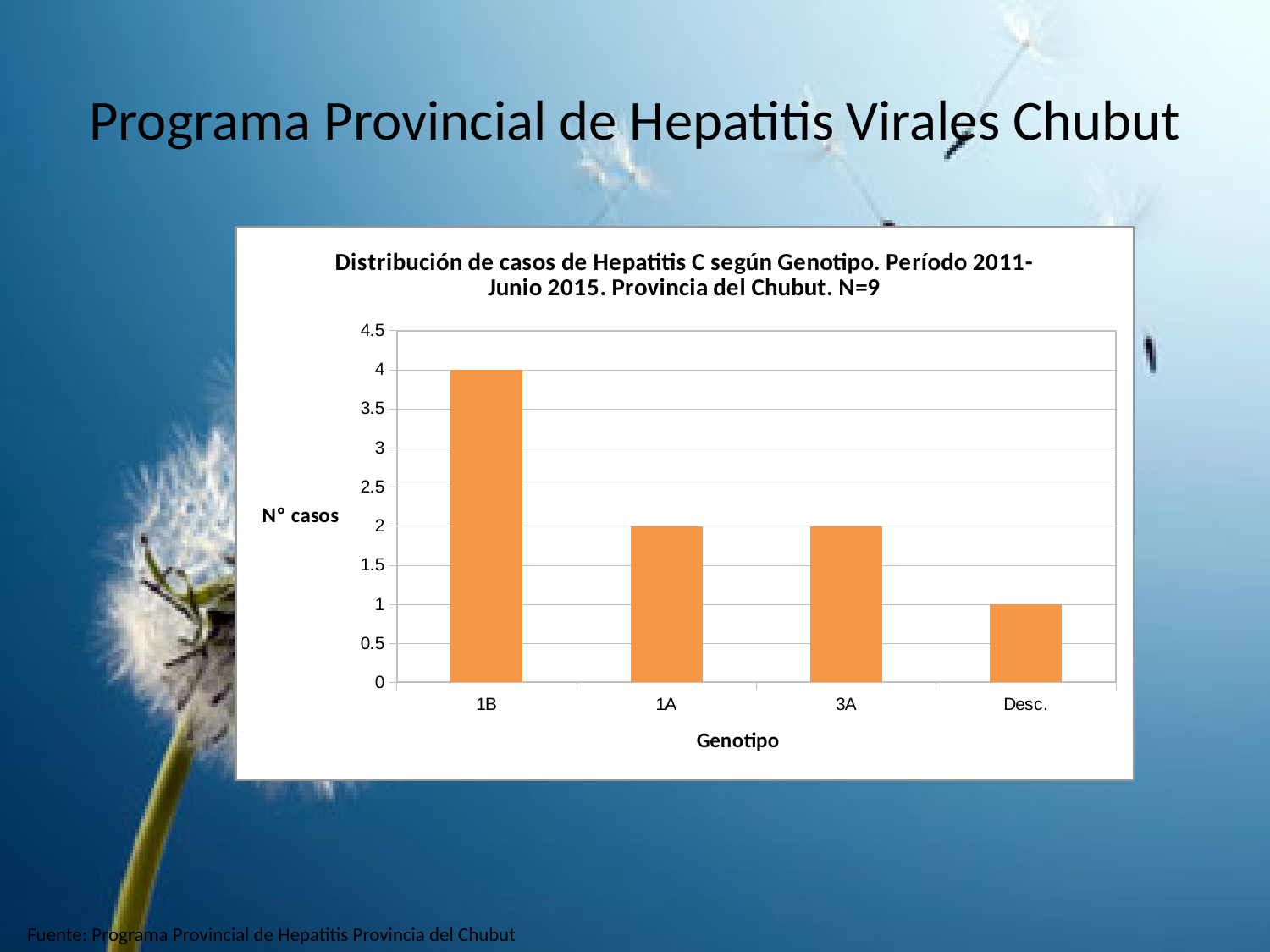
How many genotype categories are shown on the x axis? 4 What is the label of the y axis? N° casos Which has more cases, genotype 1B or the Desc. category? 1B What kind of chart is shown on the slide? bar chart How many cases are shown for genotype 1B? 4 How many cases are shown for the Desc. category? 1 Which category has the lowest number of cases? Desc. What is the label of the x axis? Genotipo How many cases are shown for genotype 1A? 2 How many cases are shown for genotype 3A? 2 Which genotype has the highest number of cases? 1B What is the difference in number of cases between genotype 1B and genotype 1A? 2